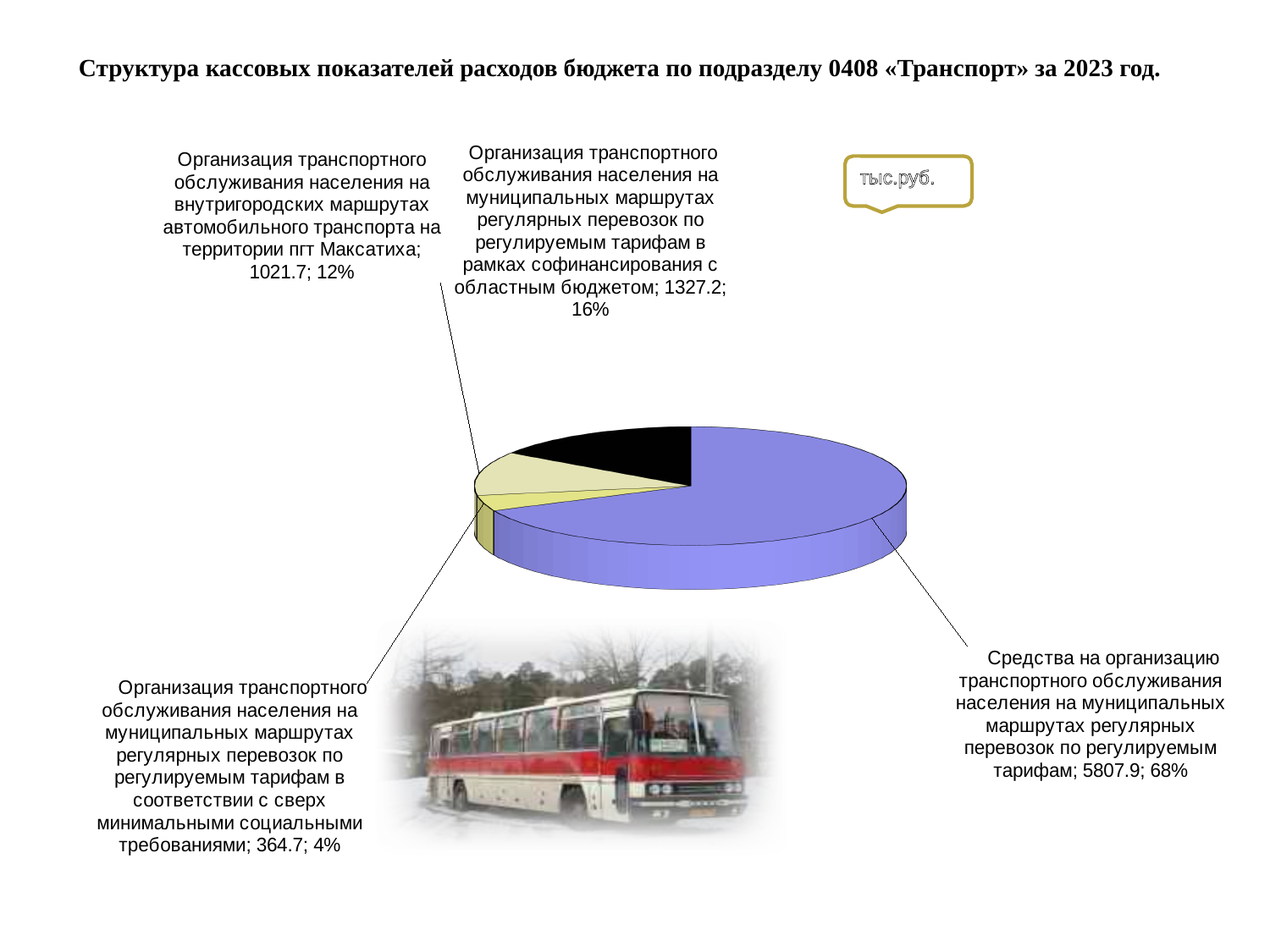
What is the value for «Организация транспортного обслуживания населения на муниципальных маршрутах регулярных перевозок по регулируемым тарифам в рамках софинансирования с областным бюджетом»? 1327.2 What kind of chart is shown on the slide? pie chart What is the total of all four slice values shown on the pie chart? 8521.5 What unit of measurement is indicated in the callout box on the slide? тыс.руб. What share of the pie does «Организация транспортного обслуживания населения на внутригородских маршрутах автомобильного транспорта на территории пгт Максатиха» represent? 12% What is the value for «Средства на организацию транспортного обслуживания населения на муниципальных маршрутах регулярных перевозок по регулируемым тарифам»? 5807.9 Which category has the smallest slice of the pie? Организация транспортного обслуживания населения на муниципальных маршрутах регулярных перевозок по регулируемым тарифам в соответствии с сверх минимальными социальными требованиями Which category has the largest slice of the pie? Средства на организацию транспортного обслуживания населения на муниципальных маршрутах регулярных перевозок по регулируемым тарифам What is the difference between the value for «... в рамках софинансирования с областным бюджетом» (1327.2) and the value for «... на территории пгт Максатиха» (1021.7)? 305.5 How many slices does the pie chart have? 4 Which is larger: the value for «... на территории пгт Максатиха» or the value for «... в соответствии с сверх минимальными социальными требованиями»? Организация транспортного обслуживания населения на внутригородских маршрутах автомобильного транспорта на территории пгт Максатиха What share of the pie does the slice «... в соответствии с сверх минимальными социальными требованиями» represent? 4%